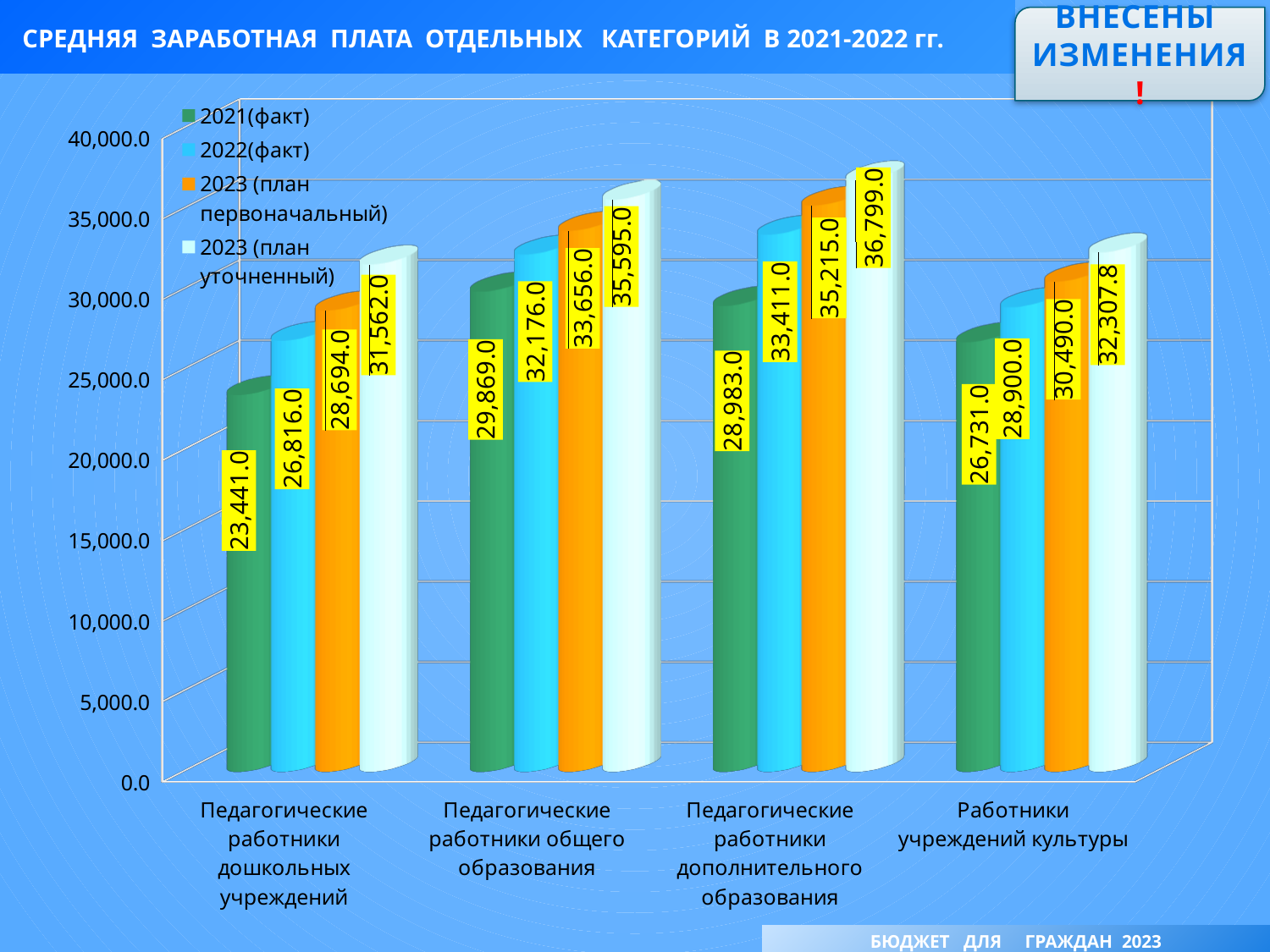
Which is larger: the 2022(факт) value for Педагогические работники общего образования or for Педагогические работники дополнительного образования? Педагогические работники дополнительного образования How many series does the legend list? 4 What is the 2023 (план уточненный) value for Педагогические работники дополнительного образования? 36,799.0 How many categories are shown on the x axis? 4 Is the 2023 (план первоначальный) value for Работники учреждений культуры greater or less than 30,000.0? greater Which category has the highest 2023 (план уточненный) value? Педагогические работники дополнительного образования What is the 2023 (план уточненный) value for Работники учреждений культуры? 32,307.8 What is the 2022(факт) value for Педагогические работники общего образования? 32,176.0 What kind of chart is shown on the slide? bar chart What is the difference between the 2023 (план уточненный) and 2021(факт) values for Педагогические работники дошкольных учреждений? 8,121.0 Which category has the lowest 2021(факт) value? Педагогические работники дошкольных учреждений What is the 2021(факт) value for Педагогические работники дошкольных учреждений? 23,441.0